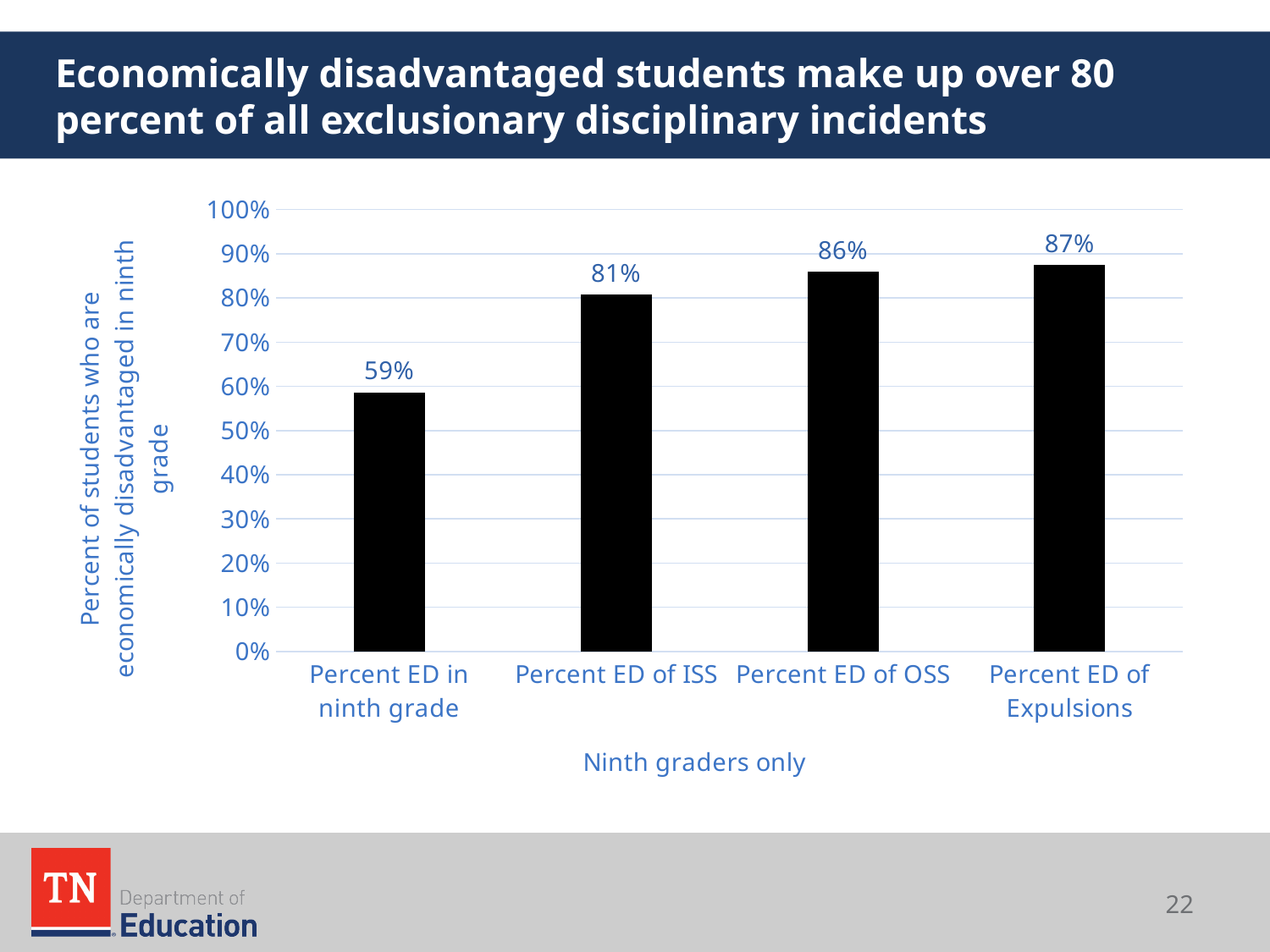
Which category has the lowest value? Percent ED in ninth grade What is the value for Percent ED of OSS? 86% What kind of chart is shown on the slide? bar chart What is the value for Percent ED of Expulsions? 87% What is the x-axis title of the chart? Ninth graders only Which is larger, Percent ED of ISS or Percent ED in ninth grade? Percent ED of ISS What is the difference between Percent ED of OSS and Percent ED of ISS? 5% How many categories are shown on the x axis? 4 What is the value for Percent ED of ISS? 81% What is the value for Percent ED in ninth grade? 59% Is the value for Percent ED of OSS greater or less than 80%? greater What is the difference between Percent ED of Expulsions and Percent ED in ninth grade? 28%